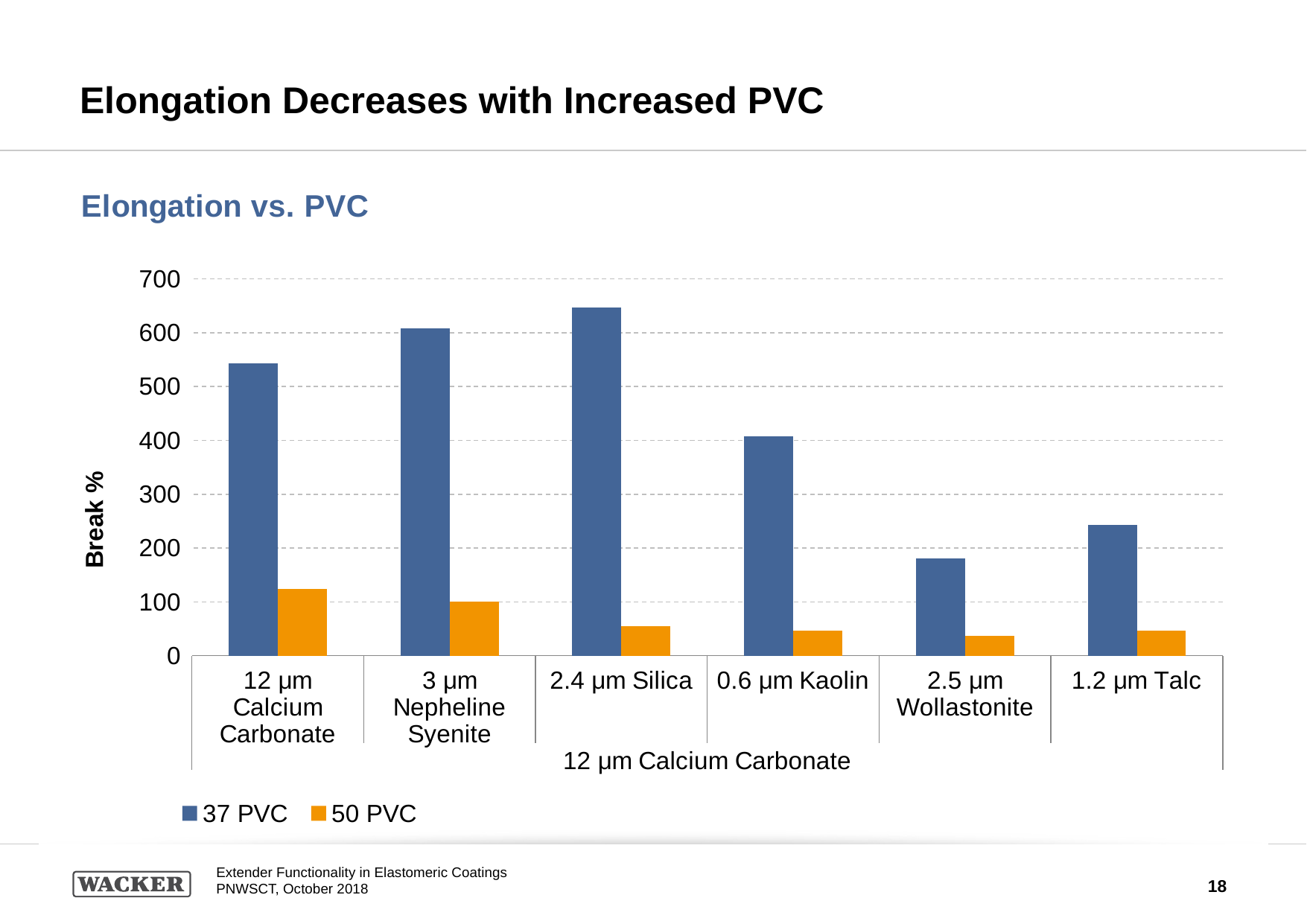
Which extender has the highest 50 PVC value? 12 µm Calcium Carbonate Is the 37 PVC value for 2.5 µm Wollastonite greater or less than 200? less How many series does the legend list? 2 For each extender, which series has the larger value, 37 PVC or 50 PVC? 37 PVC What is the label on the vertical axis? Break % What kind of chart is shown on the slide? bar chart Is the 50 PVC value for 12 µm Calcium Carbonate greater or less than 100? greater Which extender has the highest 37 PVC value? 2.4 µm Silica Which extender has the lowest 37 PVC value? 2.5 µm Wollastonite Which is larger, the 37 PVC value for 0.6 µm Kaolin or the 37 PVC value for 1.2 µm Talc? 0.6 µm Kaolin How many extender categories are shown on the x axis? 6 Is the 37 PVC value for 2.4 µm Silica greater or less than 600? greater